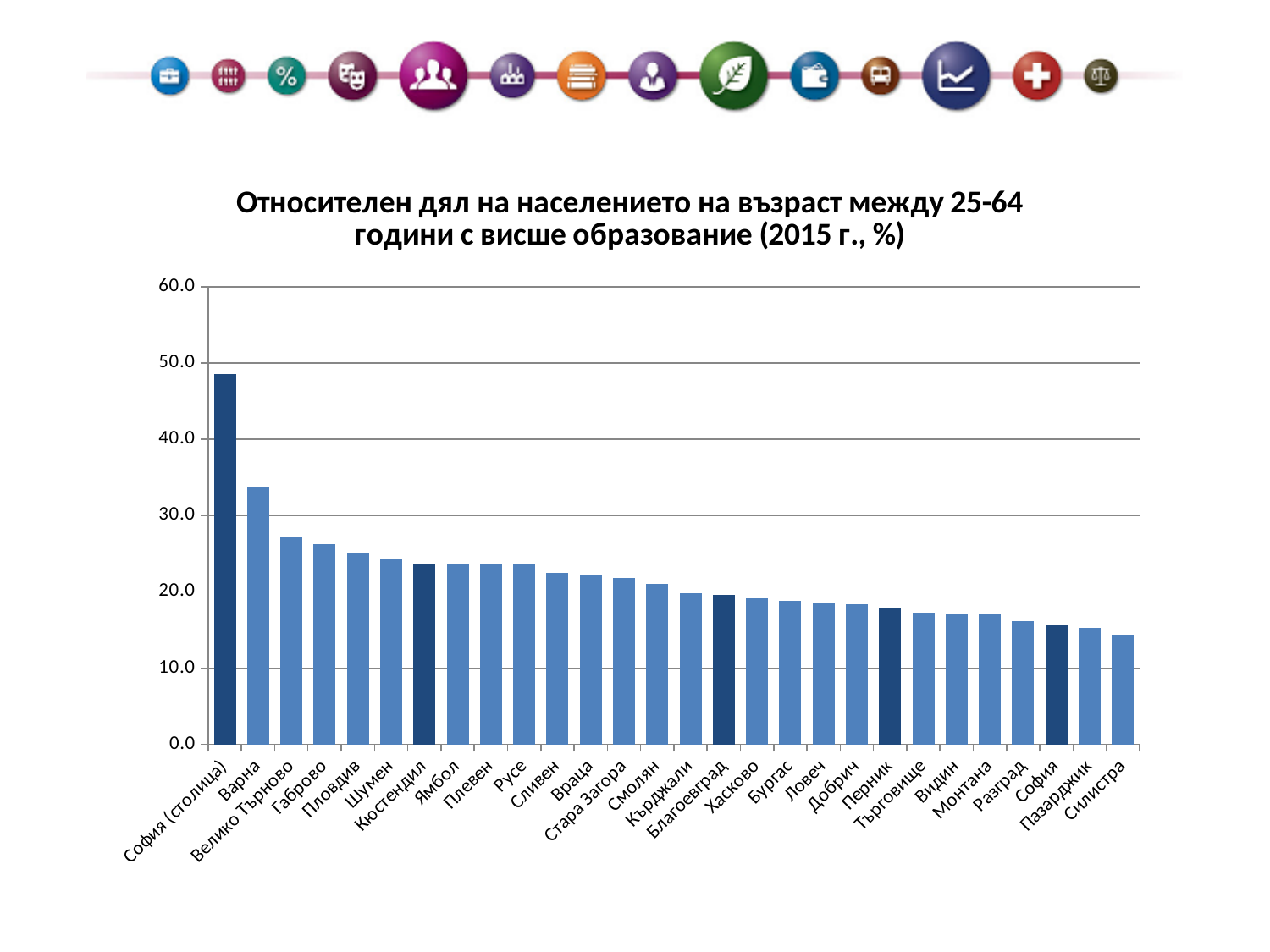
Is the value for Силистра greater or less than 20? less Which has a larger value, Варна or Велико Търново? Варна What kind of chart is shown on the slide? bar chart Which region has the lowest share of population aged 25-64 with higher education? Силистра Is the value for Варна greater or less than 30? greater Is the value for София (столица) greater or less than 40? greater Which region has the highest share of population aged 25-64 with higher education? София (столица) Do the values rise or fall moving from left to right along the x axis? fall What year does the chart title say the data refers to? 2015 How many regions are shown on the x axis of the chart? 28